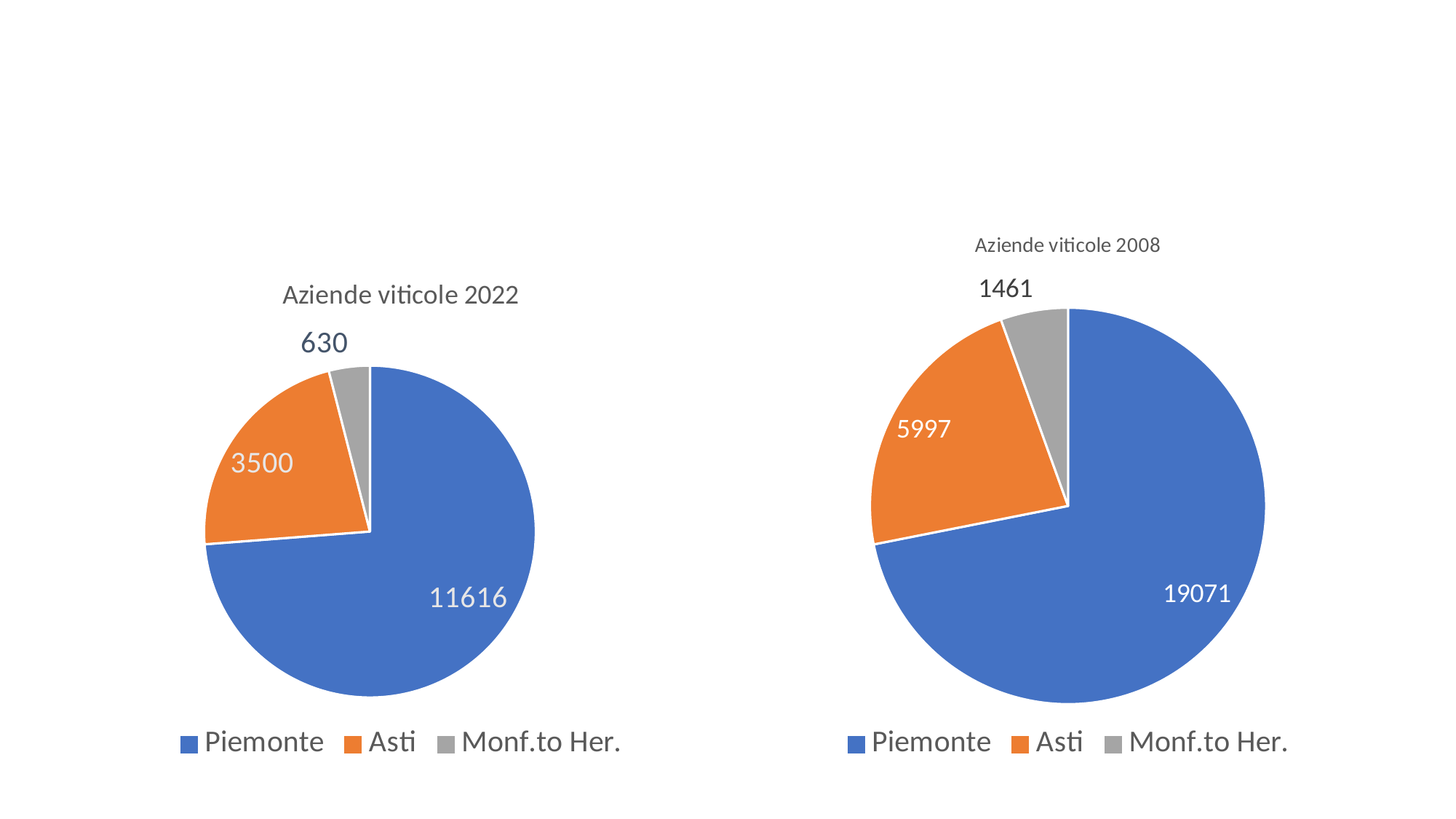
In the 'Aziende viticole 2022' chart, which category has the smallest slice? Monf.to Her. In the 'Aziende viticole 2022' chart, what share of the total does Asti represent? 22.2% In the 'Aziende viticole 2008' chart, what is the value for Asti? 5997 Is the Asti value larger in the 'Aziende viticole 2008' chart or in the 'Aziende viticole 2022' chart? Aziende viticole 2008 In the 'Aziende viticole 2008' chart, which category has the largest slice? Piemonte In the 'Aziende viticole 2022' chart, what is the difference between the Piemonte and Asti values? 8116 How many categories does the legend of the 'Aziende viticole 2022' chart list? 3 In the 'Aziende viticole 2022' chart, what is the value for Piemonte? 11616 In the 'Aziende viticole 2022' chart, what is the value for Asti? 3500 What type of chart is used on this slide? Pie chart What is the difference between the Piemonte value in the 'Aziende viticole 2008' chart and the Piemonte value in the 'Aziende viticole 2022' chart? 7455 In the 'Aziende viticole 2008' chart, what is the value for Monf.to Her.? 1461